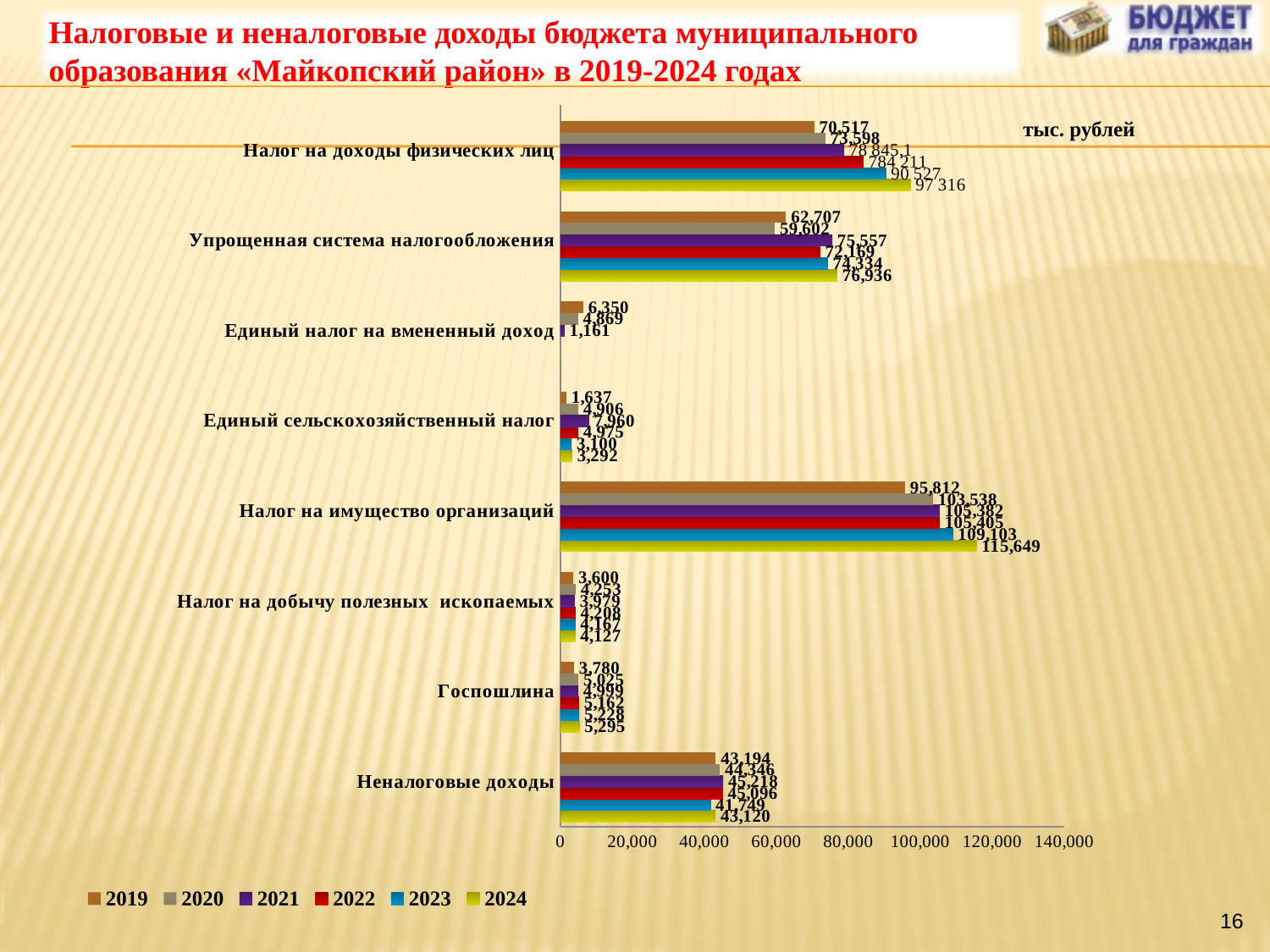
What is the 2019 value for Налог на доходы физических лиц? 70,517 Do the values for Налог на доходы физических лиц rise or fall from 2019 to 2024? rise How many revenue categories are plotted on the chart? 8 What is the 2024 value for Налог на имущество организаций? 115,649 How many series does the legend list? 6 Is the 2024 value for Налог на доходы физических лиц greater or less than 100,000? less Which category has the highest 2024 value? Налог на имущество организаций Which is larger in 2019: Налог на доходы физических лиц or Упрощенная система налогообложения? Налог на доходы физических лиц What kind of chart is shown on the slide? bar chart What is the 2019 value for Единый налог на вмененный доход? 6,350 What unit is indicated on the chart? тыс. рублей What is the difference between the 2024 and 2019 values for Налог на имущество организаций? 19,837